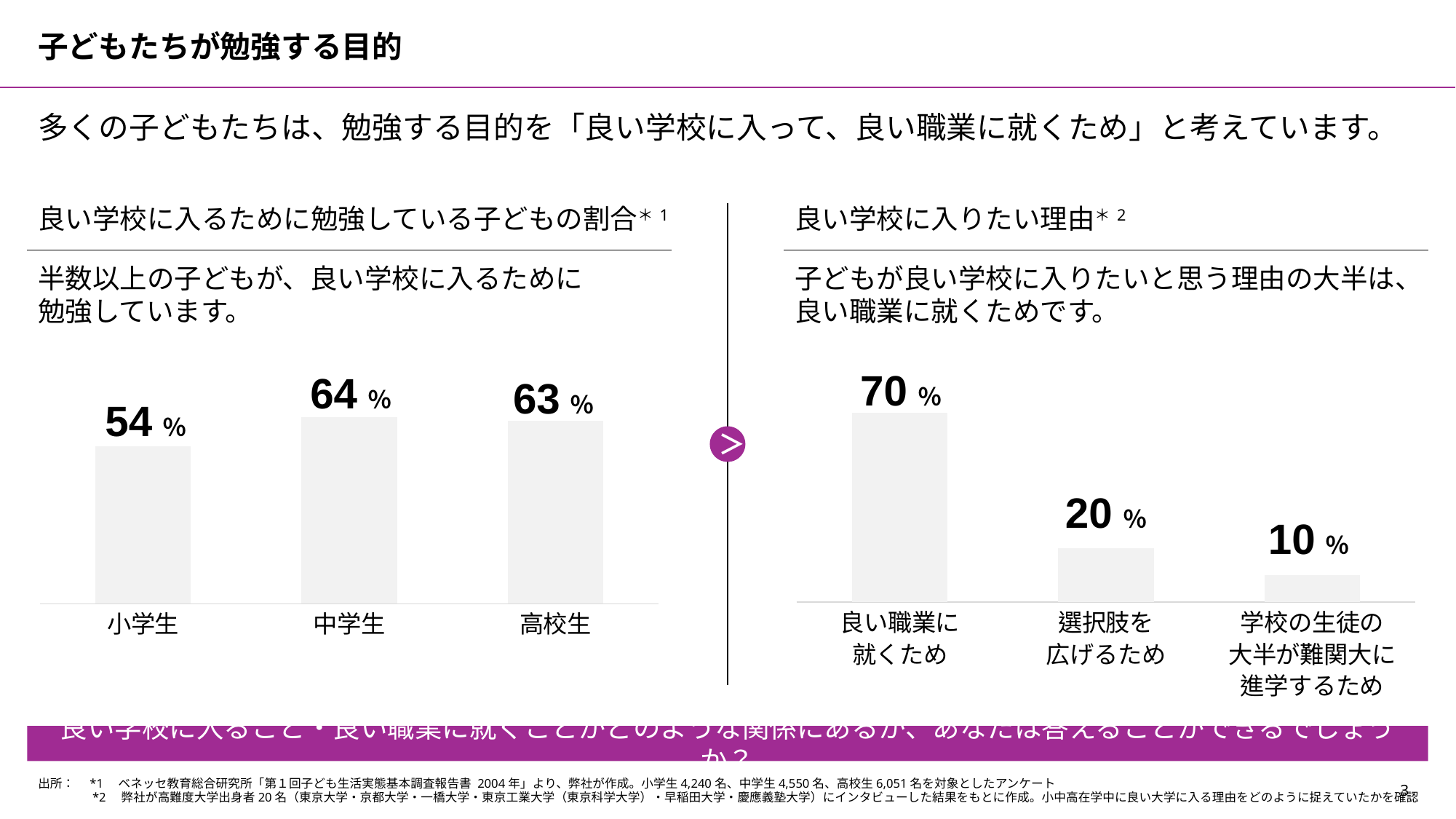
In the left chart (良い学校に入るために勉強している子どもの割合), what is the value for 高校生? 63% In the left chart (良い学校に入るために勉強している子どもの割合), what is the value for 小学生? 54% In the left chart (良い学校に入るために勉強している子どもの割合), what is the difference between the values for 中学生 and 小学生? 10% In the right chart (良い学校に入りたい理由), what is the value for 良い職業に就くため? 70% In the right chart (良い学校に入りたい理由), which category has the highest value? 良い職業に就くため In the left chart (良い学校に入るために勉強している子どもの割合), how many categories are shown? 3 In the right chart (良い学校に入りたい理由), do the values rise or fall from left to right? fall In the left chart (良い学校に入るために勉強している子どもの割合), what is the value for 中学生? 64% What kind of chart is the right chart (良い学校に入りたい理由)? bar chart In the right chart (良い学校に入りたい理由), what is the value for 選択肢を広げるため? 20% In the right chart (良い学校に入りたい理由), what is the value for 学校の生徒の大半が難関大に進学するため? 10% In the left chart (良い学校に入るために勉強している子どもの割合), which category has the lowest value? 小学生